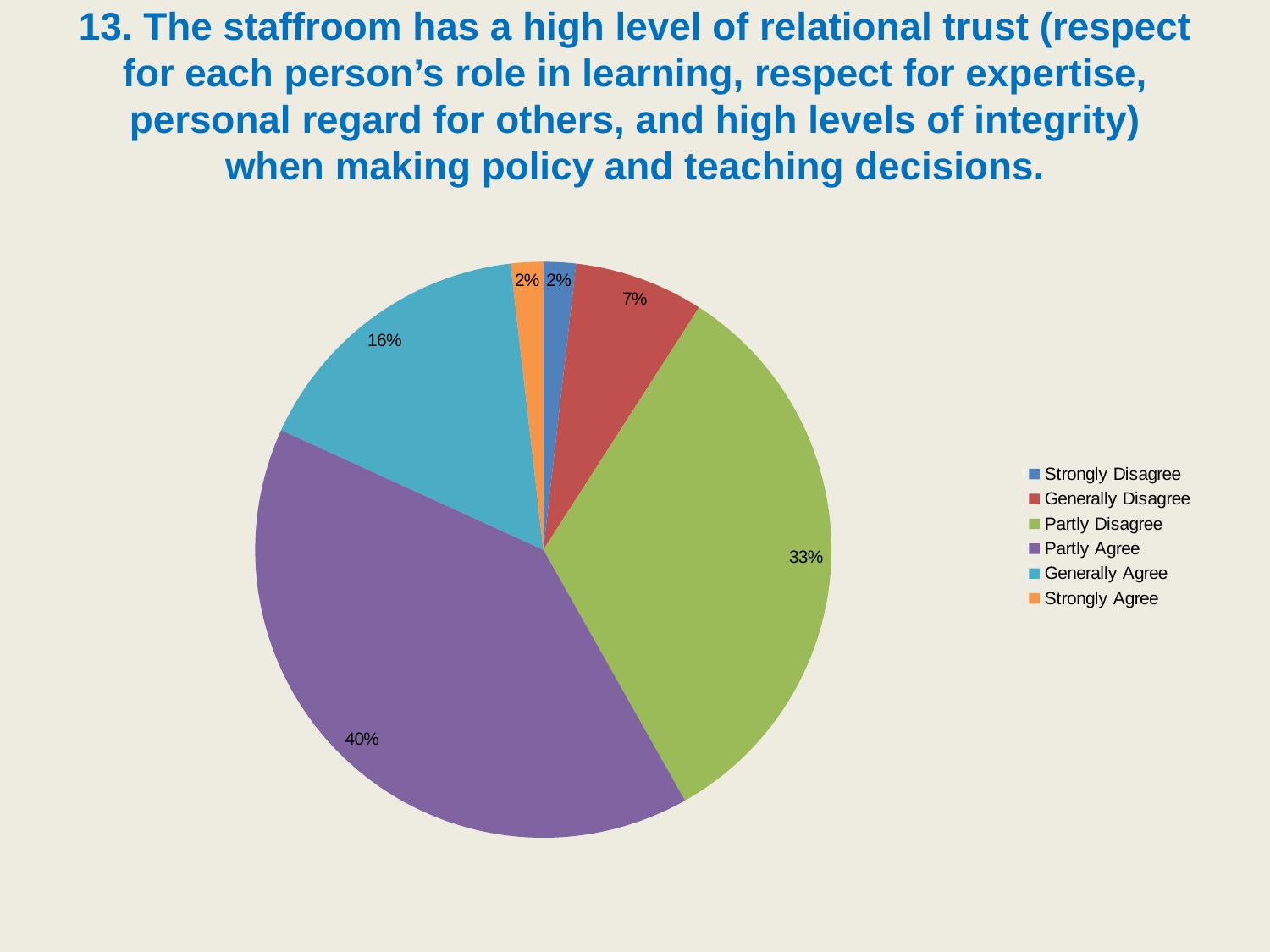
What percentage of respondents chose Generally Agree? 16% Which response category has the largest share of the pie? Partly Agree What colour is the Partly Disagree slice? Green What is the combined share of Partly Agree and Generally Agree? 56% What percentage of respondents chose Partly Disagree? 33% How many response categories does the pie chart show? 6 What percentage of respondents chose Partly Agree? 40% What kind of chart is shown on the slide? Pie chart What percentage of respondents chose Generally Disagree? 7% What is the difference in percentage points between Partly Agree and Partly Disagree? 7 Which is larger, the share for Generally Agree or the share for Generally Disagree? Generally Agree What percentage of respondents chose Strongly Agree? 2%